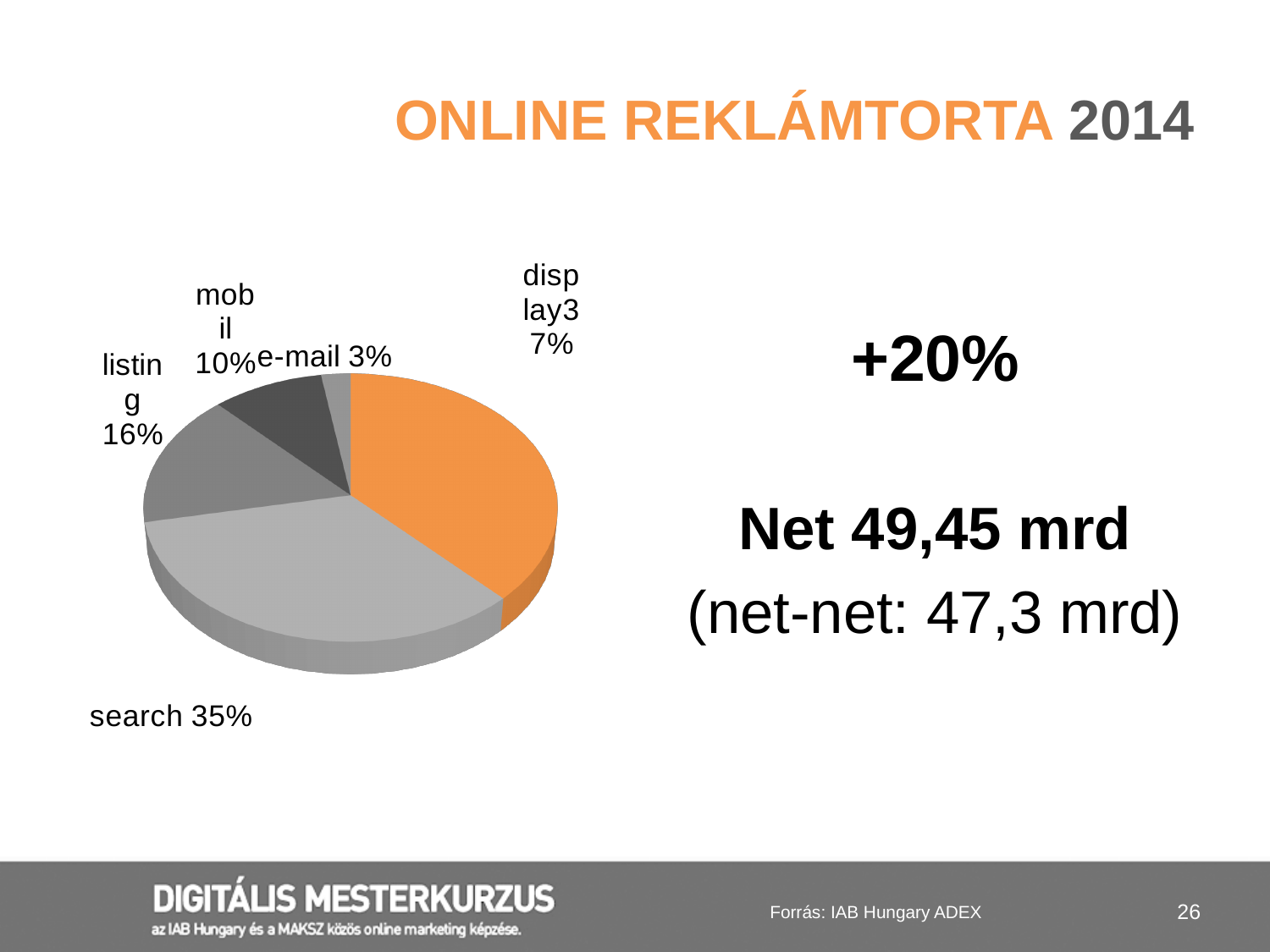
Which category has the smallest slice of the pie? e-mail What share of the pie does mobil have? 10% What kind of chart is shown on the slide? pie chart What colour is the display slice of the pie? orange What is the difference between the share for search and the share for listing? 19% What share of the pie does listing have? 16% What share of the pie does display have? 37% Which category has the largest slice of the pie? display Which is larger, the share for search or the share for listing? search What share of the pie does search have? 35% How many slices does the pie chart have? 5 What share of the pie does e-mail have? 3%